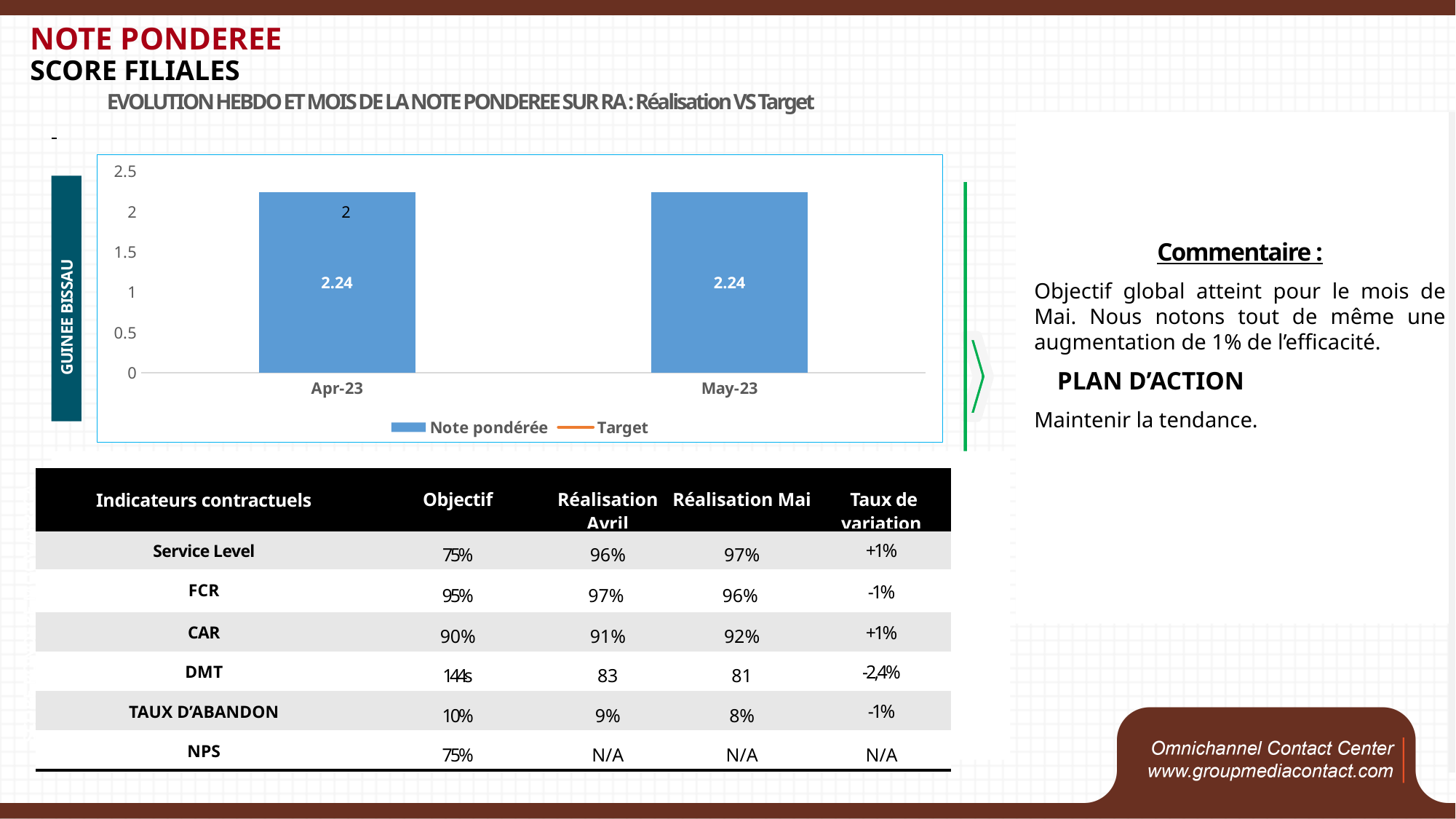
Is the Note pondérée value for Apr-23 greater or less than 2.5? less What kind of chart is shown on the slide? bar chart How many series does the chart legend list? 2 What is the Note pondérée value for Apr-23? 2.24 What are the two series named in the chart legend? Note pondérée and Target What is the difference between the Note pondérée values for Apr-23 and May-23? 0 What is the Note pondérée value for May-23? 2.24 Is the Note pondérée value for May-23 greater or less than 2? greater Does the Note pondérée rise, fall or stay the same from Apr-23 to May-23? stays the same How many months are plotted on the x axis of the chart? 2 What colour are the Note pondérée bars in the chart? blue